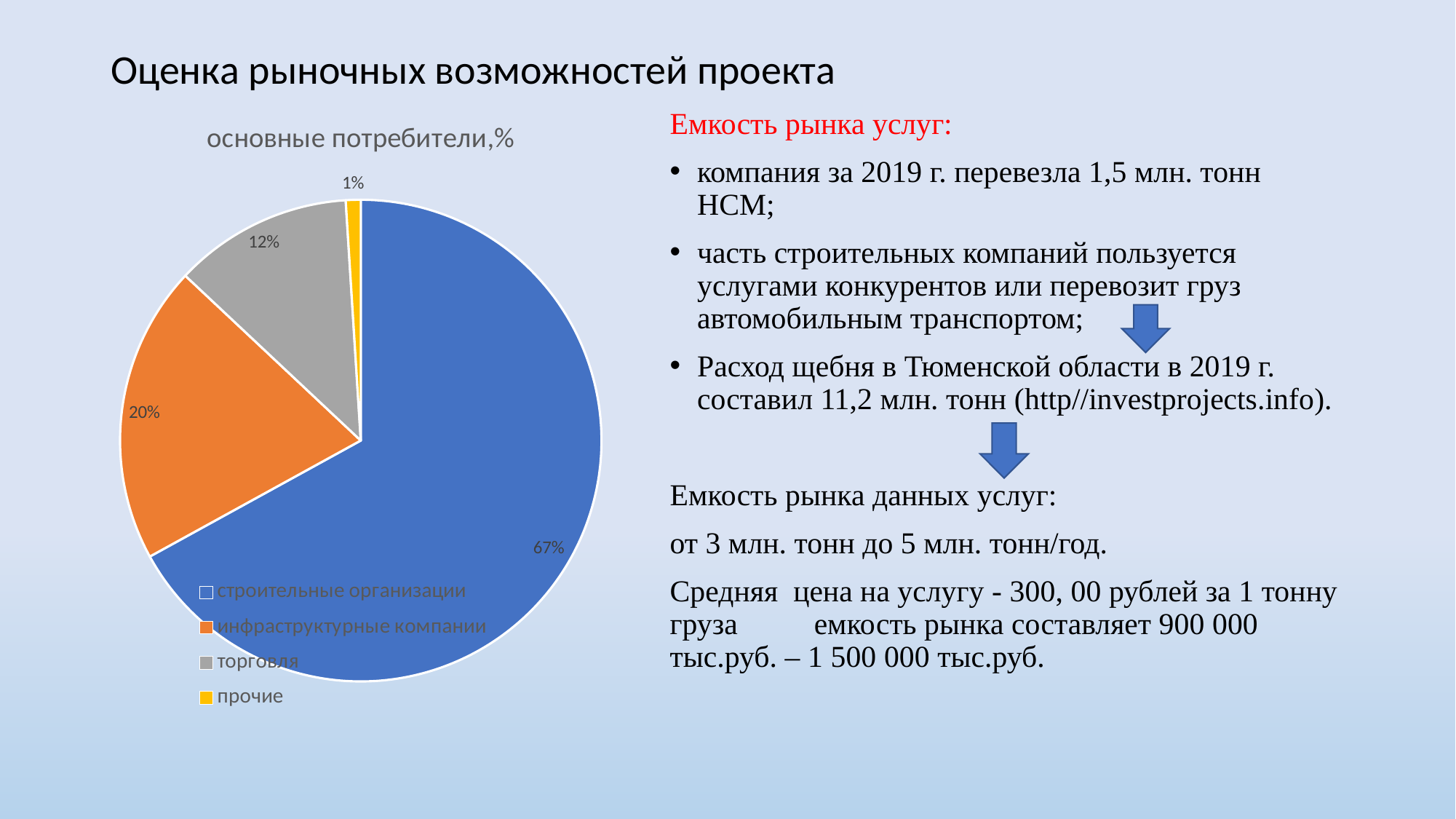
How many categories does the pie chart show? 4 What share of the pie is labelled for строительные организации? 67% What is the difference in percentage points between строительные организации and инфраструктурные компании? 47 Which is larger: the slice for торговля or the slice for инфраструктурные компании? инфраструктурные компании What share of the pie is labelled for торговля? 12% What share of the pie is labelled for инфраструктурные компании? 20% What colour is the slice for торговля? grey Which category has the largest slice of the pie? строительные организации What share of the pie is labelled for прочие? 1% Which category has the smallest slice of the pie? прочие What is the title of the chart? основные потребители,% What type of chart is shown on the slide? pie chart